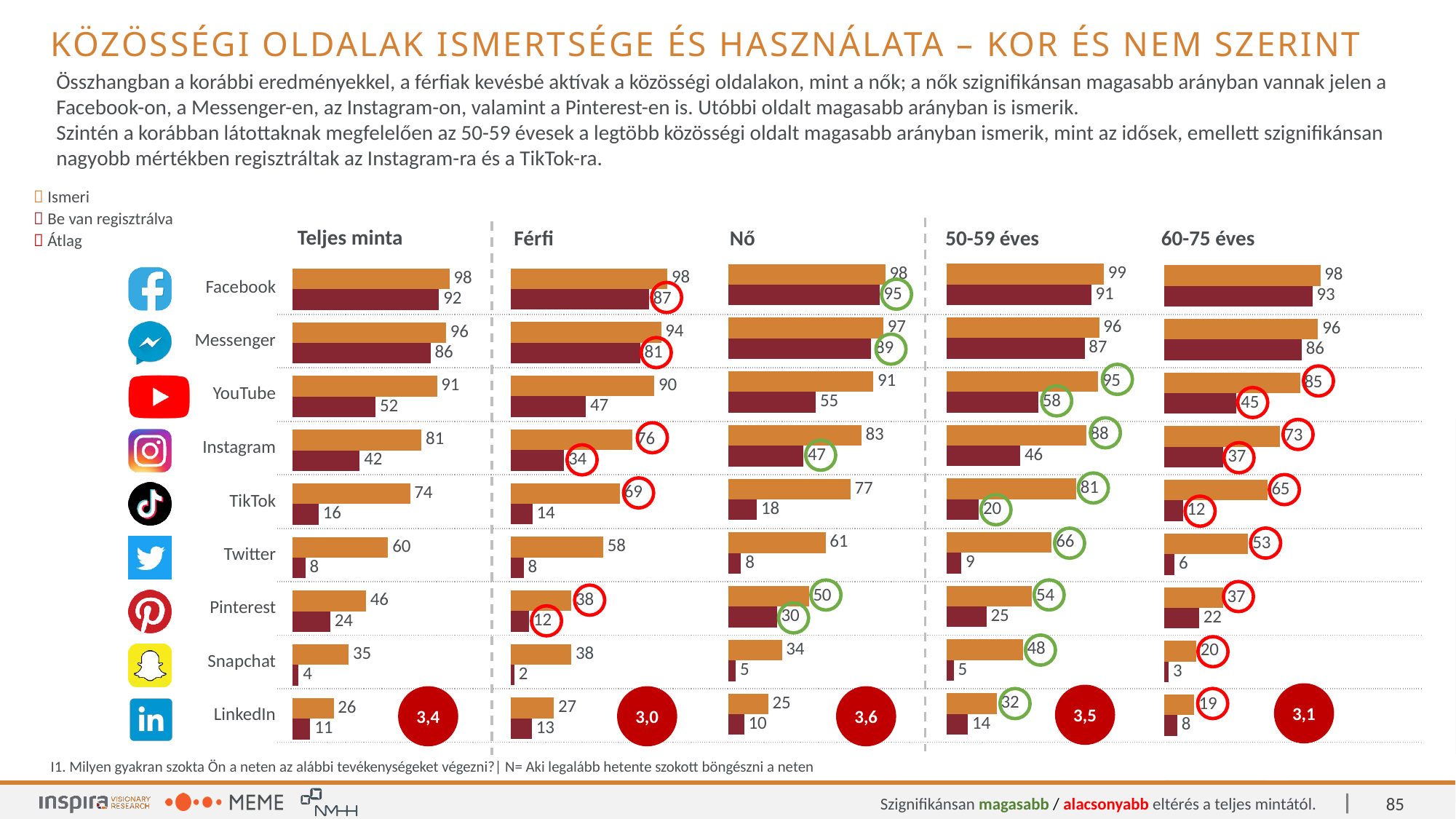
What is the 'Átlag' value shown for the 'Nő' chart? 3,6 Is the 'Be van regisztrálva' value for YouTube larger in the 'Férfi' chart or in the 'Nő' chart? Nő What kind of chart is used to show the platform values? Bar chart How many bar series does the legend list? 2 In the 'Férfi' chart, what is the 'Be van regisztrálva' value for Instagram? 34 In the '60-75 éves' chart, which platform has the lowest 'Be van regisztrálva' value? Snapchat In the '50-59 éves' chart, which platform has the highest 'Ismeri' value? Facebook In the 'Teljes minta' chart, what is the difference between the 'Ismeri' and 'Be van regisztrálva' values for TikTok? 58 In the 'Teljes minta' chart, what is the 'Ismeri' value for Facebook? 98 How many platforms are listed in each chart? 9 In the 'Nő' chart, what is the 'Ismeri' value for Pinterest? 50 In the '50-59 éves' chart, what is the 'Ismeri' value for LinkedIn? 32